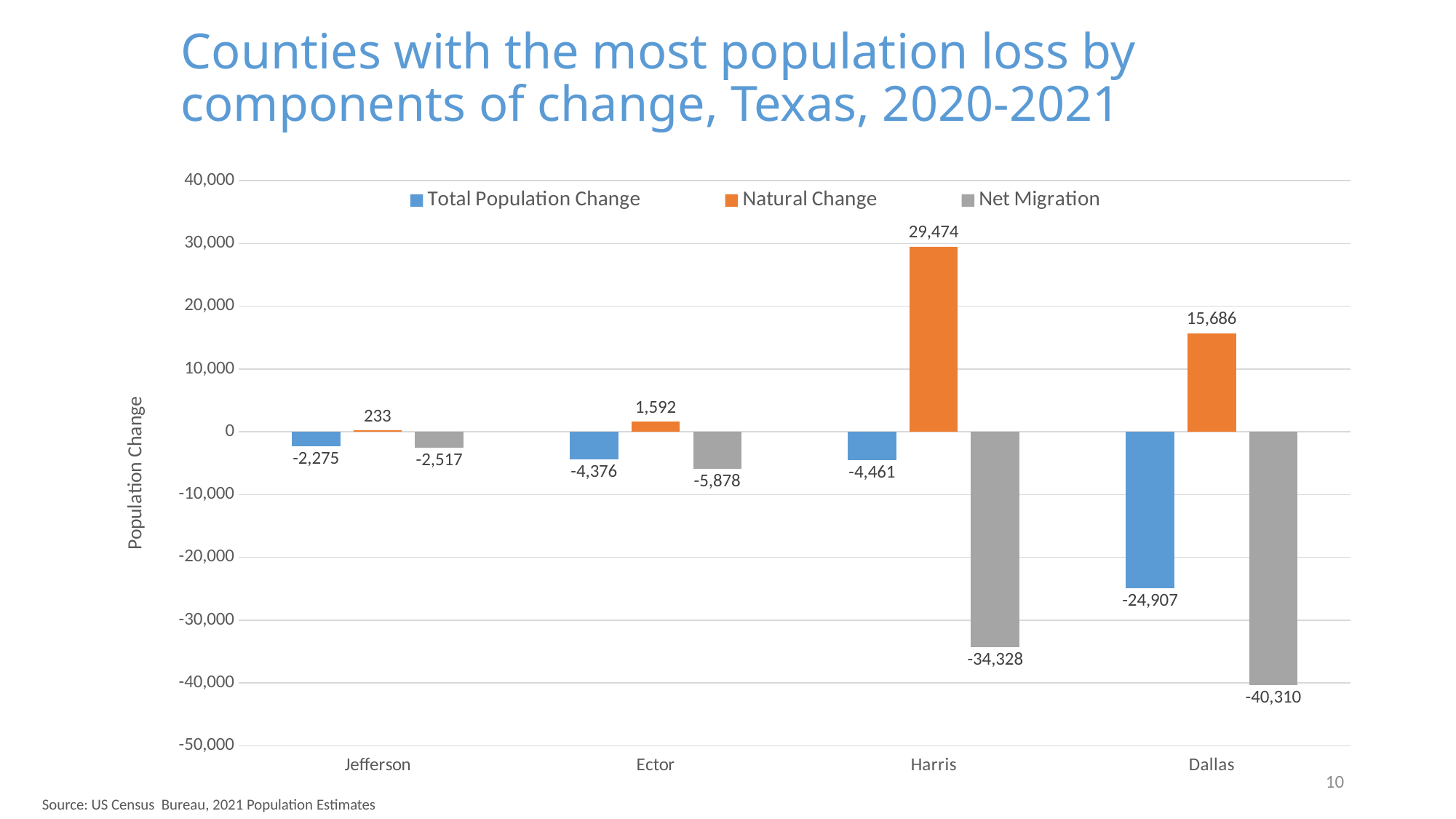
What is the Natural Change value for Jefferson? 233 What kind of chart is shown on the slide? Bar chart Which county has the highest Natural Change value? Harris How many counties are shown on the x axis? 4 Which series is shown in orange in the legend? Natural Change Which is larger, the Total Population Change for Jefferson or for Ector? Jefferson What is the Net Migration value for Ector? -5,878 What is the difference between the Natural Change values for Harris and Dallas? 13,788 What is the Total Population Change for Dallas? -24,907 How many series does the legend list? 3 What is the Natural Change value for Harris? 29,474 Which county has the lowest Net Migration value? Dallas